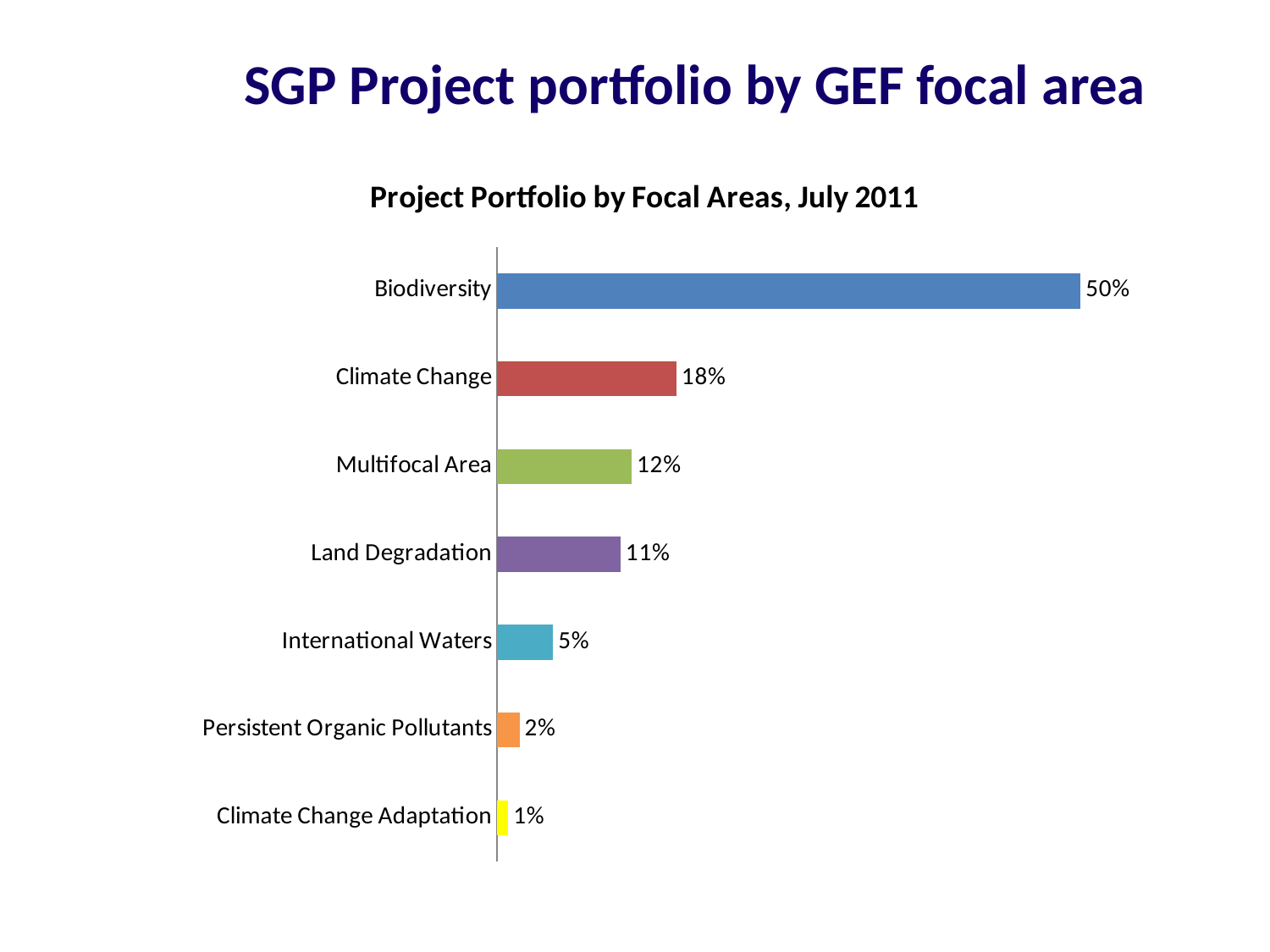
What is the difference between the values for Multifocal Area and International Waters? 7% What is the value for Persistent Organic Pollutants? 2% Which is larger, the value for Multifocal Area or the value for Land Degradation? Multifocal Area What is the value for Climate Change? 18% What kind of chart is shown on the slide? Bar chart What is the value for Land Degradation? 11% How many focal areas are shown in the chart? 7 Which focal area has the highest value? Biodiversity What is the title of the chart? Project Portfolio by Focal Areas, July 2011 What is the difference between the values for Biodiversity and Climate Change? 32% Which focal area has the lowest value? Climate Change Adaptation What is the value for Biodiversity? 50%